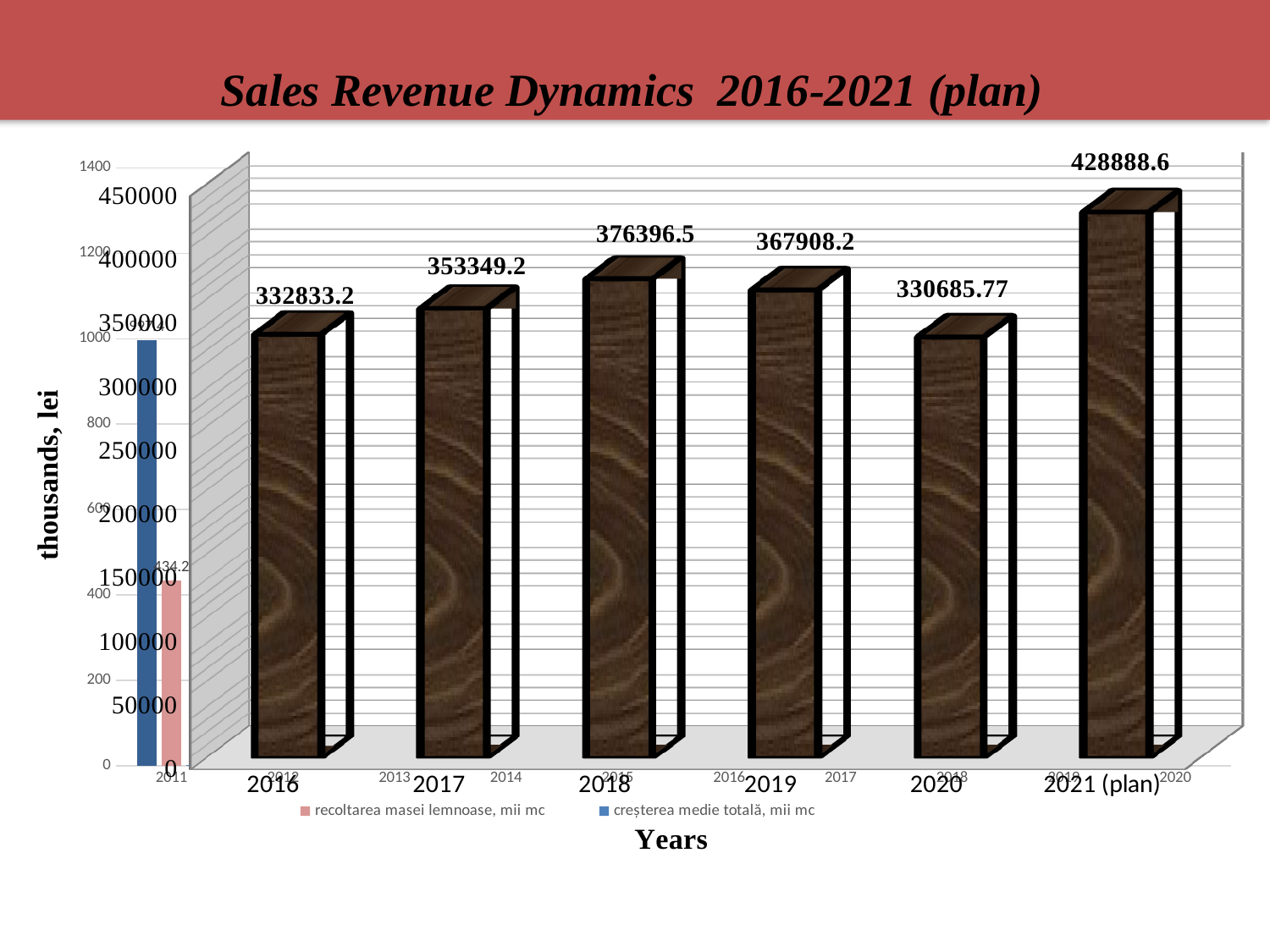
In the Sales Revenue Dynamics chart, what is the difference between the 2018 value and the 2017 value? 23047.3 In the Sales Revenue Dynamics chart, do the values rise or fall from 2016 to 2018? rise In the Sales Revenue Dynamics chart, which year has the highest value? 2021 (plan) In the Sales Revenue Dynamics chart, what is the difference between the 2021 (plan) value and the 2016 value? 96055.4 In the Sales Revenue Dynamics chart, which year has the lowest value? 2020 In the Sales Revenue Dynamics chart, what is the value for 2018? 376396.5 What kind of chart is the Sales Revenue Dynamics chart? bar chart In the Sales Revenue Dynamics chart, is the value for 2021 (plan) greater or less than 400000? greater In the Sales Revenue Dynamics chart, what is the value for 2020? 330685.77 How many years are shown as bars in the Sales Revenue Dynamics chart? 6 In the Sales Revenue Dynamics chart, which is larger, the value for 2018 or the value for 2019? 2018 In the Sales Revenue Dynamics chart, what is the value for 2016? 332833.2